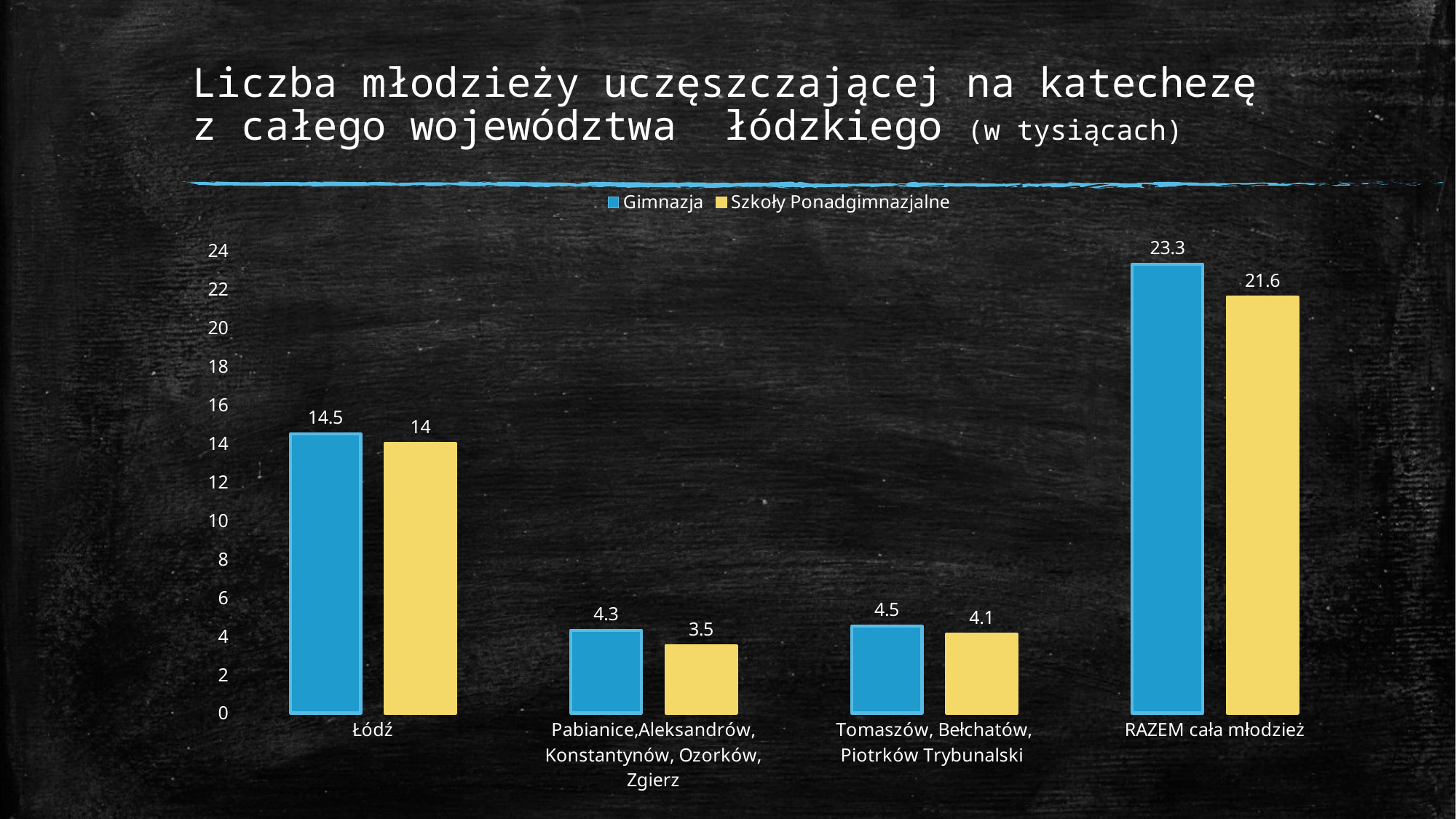
How many series does the legend list? 2 What kind of chart is shown on the slide? Bar chart Which category has the highest Gimnazja value? RAZEM cała młodzież What is the Gimnazja value for Łódź? 14.5 Which category has the lowest Szkoły Ponadgimnazjalne value? Pabianice,Aleksandrów, Konstantynów, Ozorków, Zgierz What is the Szkoły Ponadgimnazjalne value for Tomaszów, Bełchatów, Piotrków Trybunalski? 4.1 Which colour represents the Szkoły Ponadgimnazjalne series? Yellow Which is larger for Łódź: the Gimnazja value or the Szkoły Ponadgimnazjalne value? Gimnazja What is the difference between the Gimnazja and Szkoły Ponadgimnazjalne values for RAZEM cała młodzież? 1.7 What is the difference between the Gimnazja values for Łódź and Tomaszów, Bełchatów, Piotrków Trybunalski? 10 What is the Szkoły Ponadgimnazjalne value for RAZEM cała młodzież? 21.6 How many categories are shown on the x axis? 4